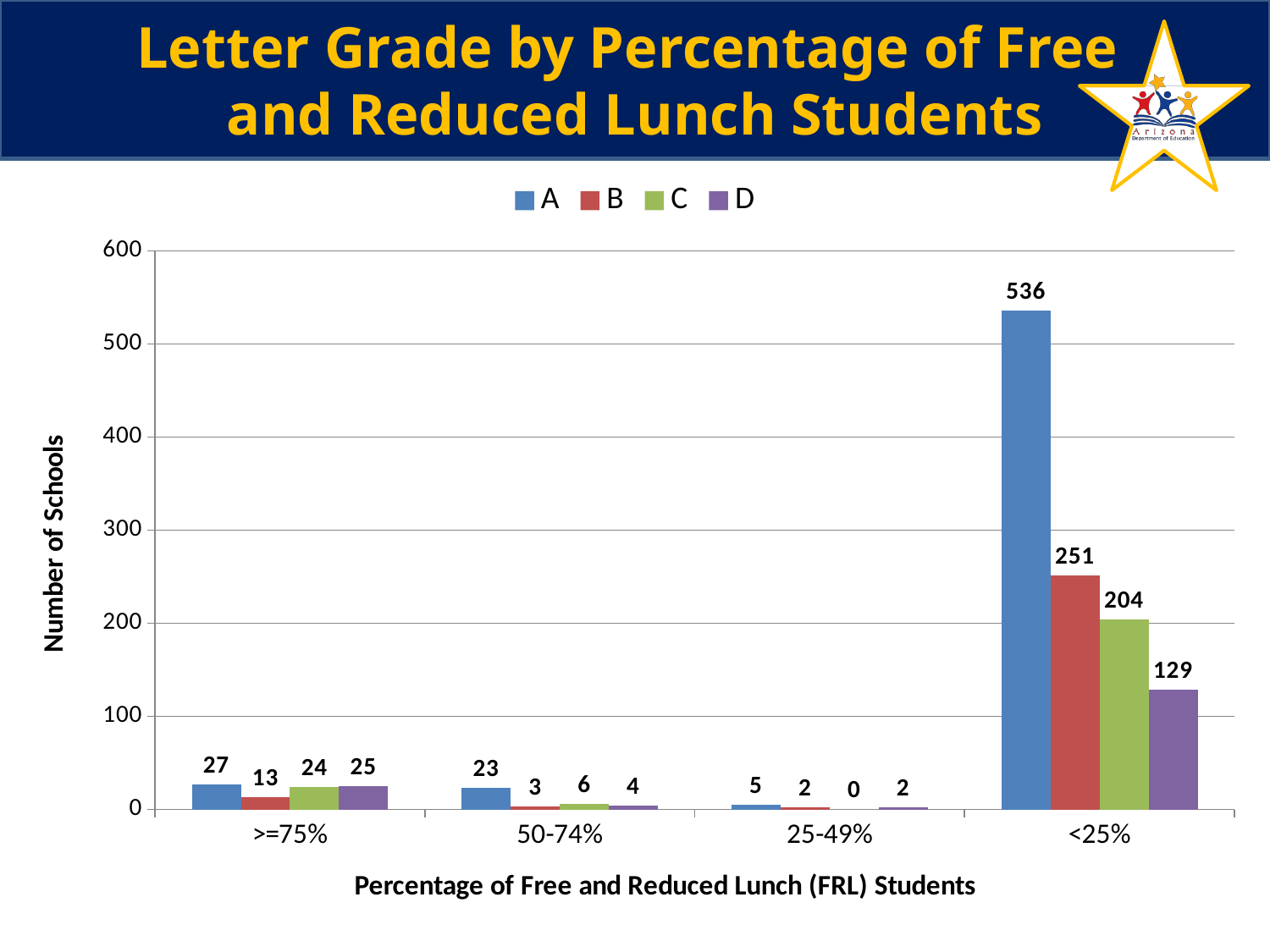
How many series does the legend list? 4 What is the value for grade C in the 25-49% FRL category? 0 In the >=75% FRL category, which is larger: the value for grade C or grade D? D Is the value for grade D in the <25% FRL category greater or less than 100? greater What is the value for grade D in the 50-74% FRL category? 4 What kind of chart is shown on the slide? bar chart How many schools with grade A are in the <25% FRL category? 536 Which FRL category has the lowest number of grade B schools? 25-49% Which FRL category has the highest number of grade A schools? <25% What is the difference between the grade A and grade B values in the <25% FRL category? 285 What is the value for grade B in the >=75% FRL category? 13 How many FRL categories are shown on the x axis? 4